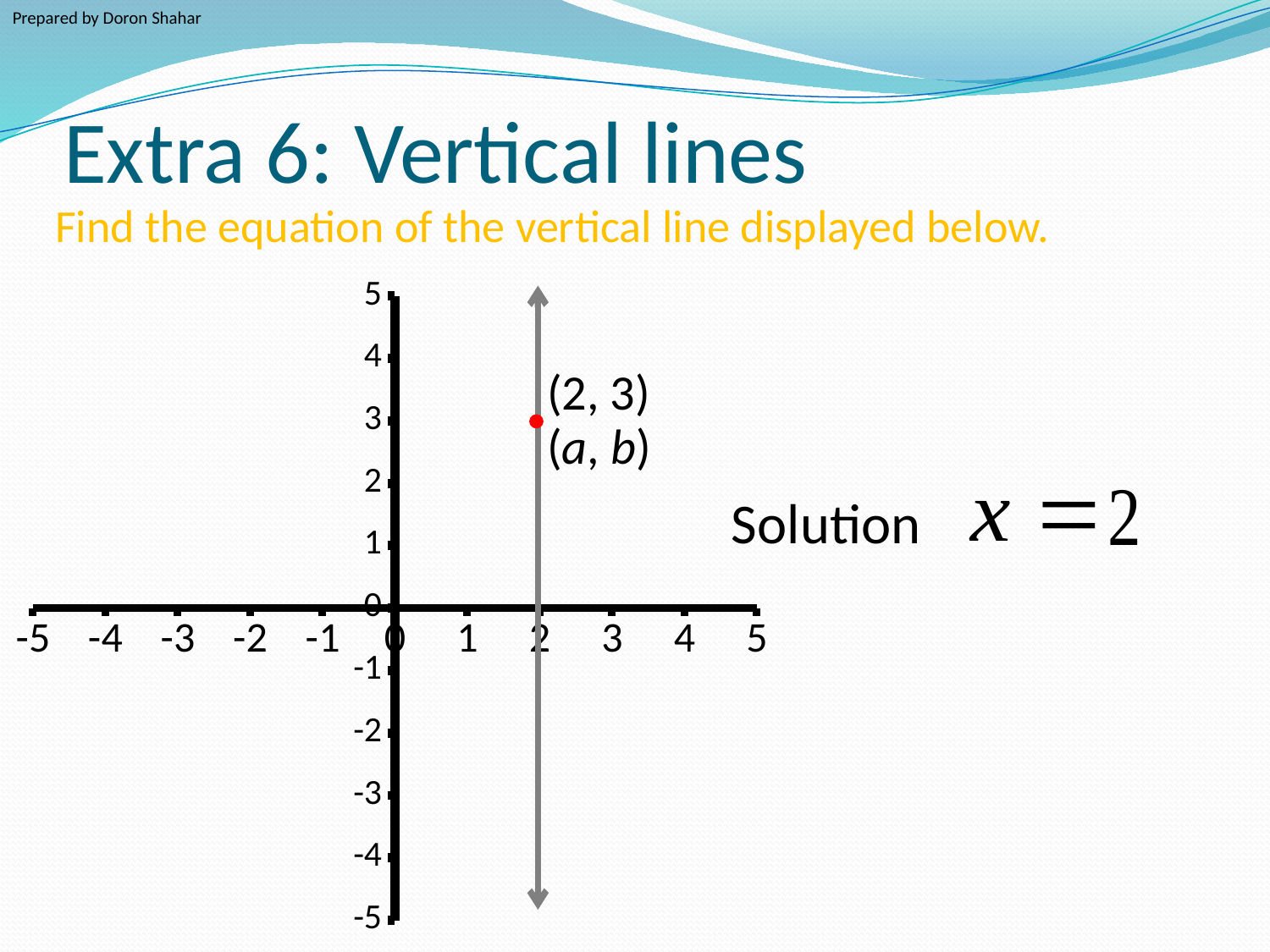
What colour is the plotted point on the graph? Red How many points are plotted on the graph? 1 What is the y-coordinate of the red point on the graph? 3 What is the smallest value labeled on the y-axis? -5 Is the y-coordinate of the red point greater or less than 5? less What is the x-coordinate of the red point on the graph? 2 At which x value does the vertical line cross the x-axis? 2 Is the x-coordinate of the red point greater or less than 0? greater What are the coordinates of the red point plotted on the graph? (2, 3) What equation is given as the solution for the vertical line shown? x = 2 What is the largest value labeled on the x-axis? 5 What general label is written beneath the coordinates (2, 3) next to the red point? (a, b)